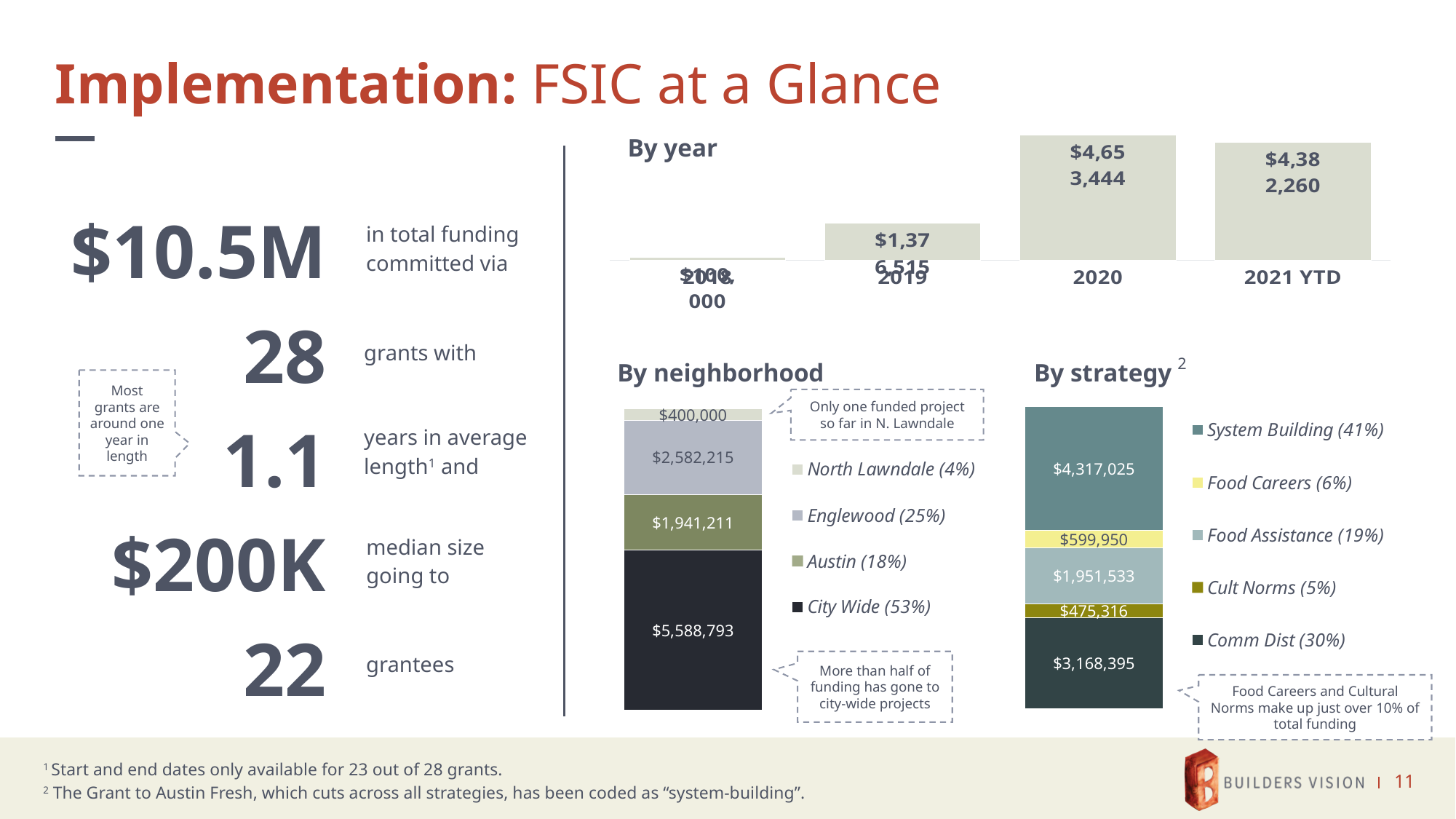
In the 'By year' chart, what is the value for 2020? $4,653,444 In the 'By neighborhood' chart, what is the total of the stacked bar? $10,512,219 In the 'By neighborhood' chart, what is the difference between the Englewood and Austin values? $641,004 In the 'By neighborhood' chart, what share of funding went to Englewood? 25% How many strategies does the legend of the 'By strategy' chart list? 5 In the 'By strategy' chart, what is the value for Food Assistance? $1,951,533 In the 'By year' chart, what is the value for 2021 YTD? $4,382,260 What kind of chart is the 'By year' chart? bar chart In the 'By neighborhood' chart, what is the value for City Wide? $5,588,793 In the 'By strategy' chart, which strategy has the smallest value? Cult Norms In the 'By year' chart, which year has the highest value? 2020 How many years are shown in the 'By year' chart? 4